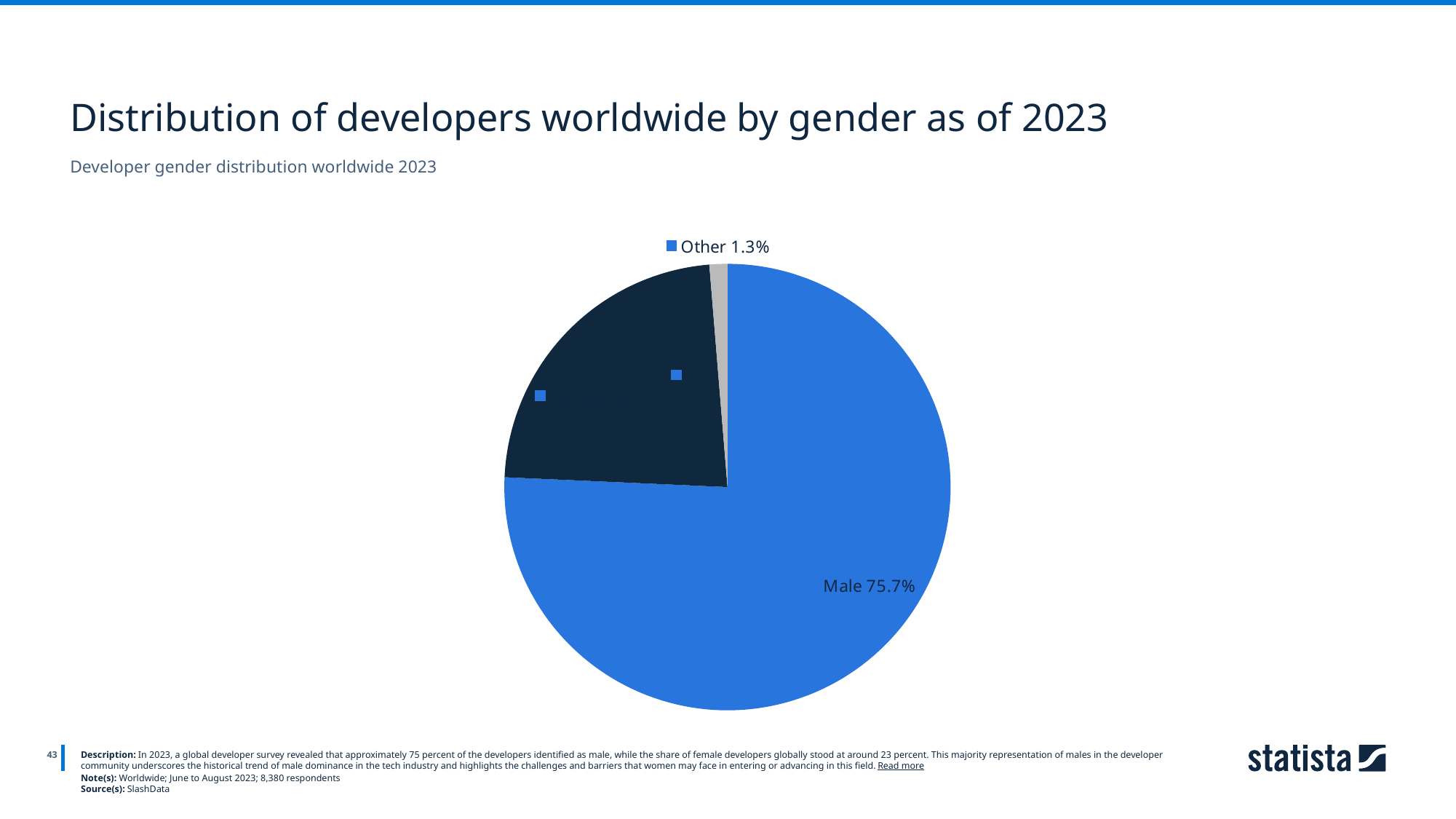
What kind of chart is shown on the slide? Pie chart Which slice of the pie chart is the smallest? Other Which slice of the pie chart is the largest? Male What share of developers worldwide is labelled as Male in the pie chart? 75.7% What is the title of the slide? Distribution of developers worldwide by gender as of 2023 What share of developers worldwide is labelled as Other in the pie chart? 1.3% How many slices does the pie chart have? 3 What is the subtitle shown below the slide title? Developer gender distribution worldwide 2023 Which is larger in the pie chart, the Male slice or the Other slice? Male What is the difference in percentage points between the Male share and the Other share? 74.4%